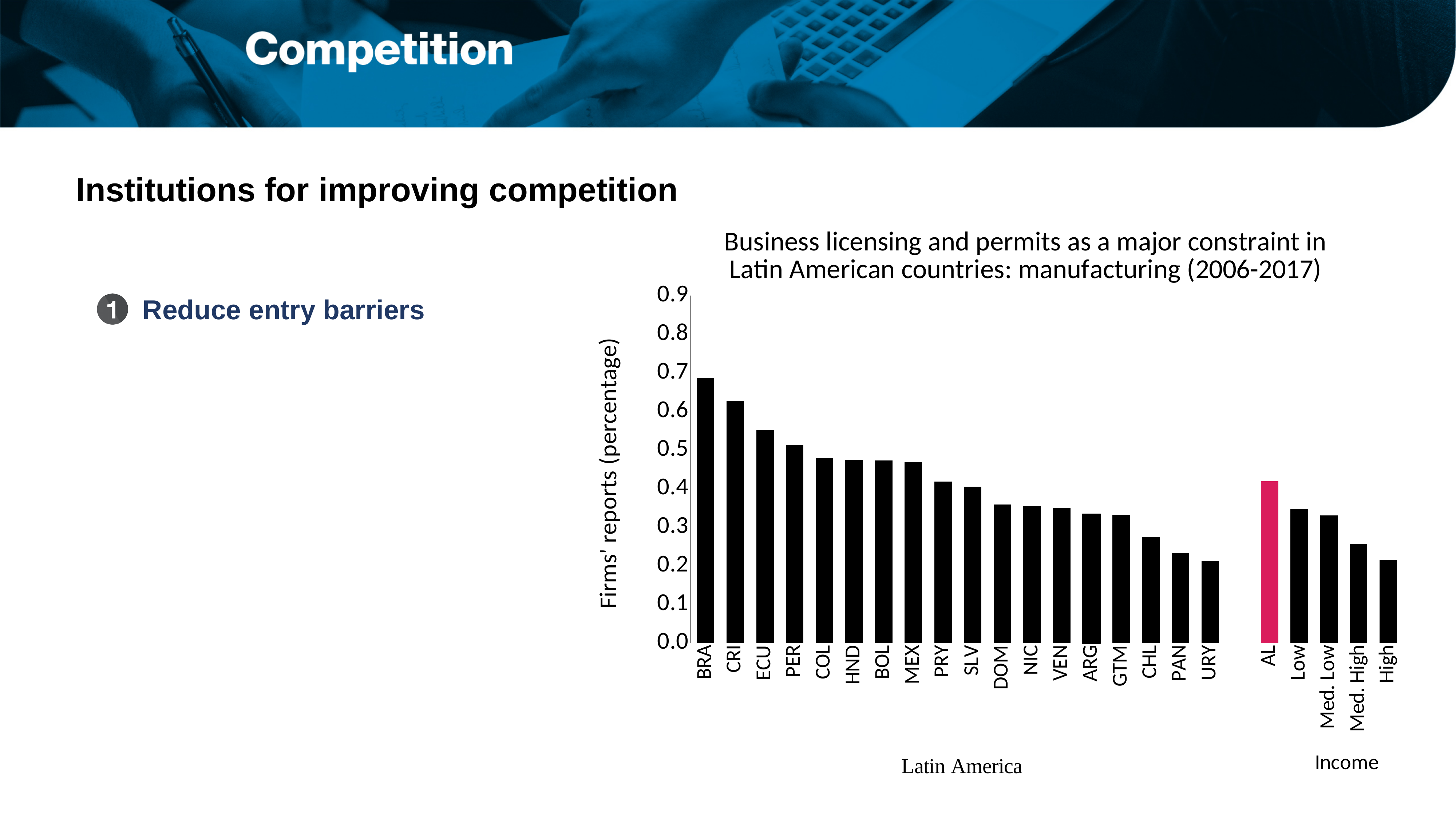
Which is larger, the value for CHL or the value for PAN? CHL Is the value for URY greater or less than 0.3? less What kind of chart is shown on the slide? Bar chart How many bars are plotted in the chart? 23 Which bar is highlighted in pink rather than black? AL Do the values for the Latin American countries rise or fall from BRA to URY along the x axis? fall Among the four income groups (Low, Med. Low, Med. High, High), which has the lowest value? High Which category has the highest value in the chart? BRA Is the value for AL greater or less than 0.5? less Is the value for BRA greater or less than 0.6? greater Which is larger, the value for BRA or the value for CRI? BRA